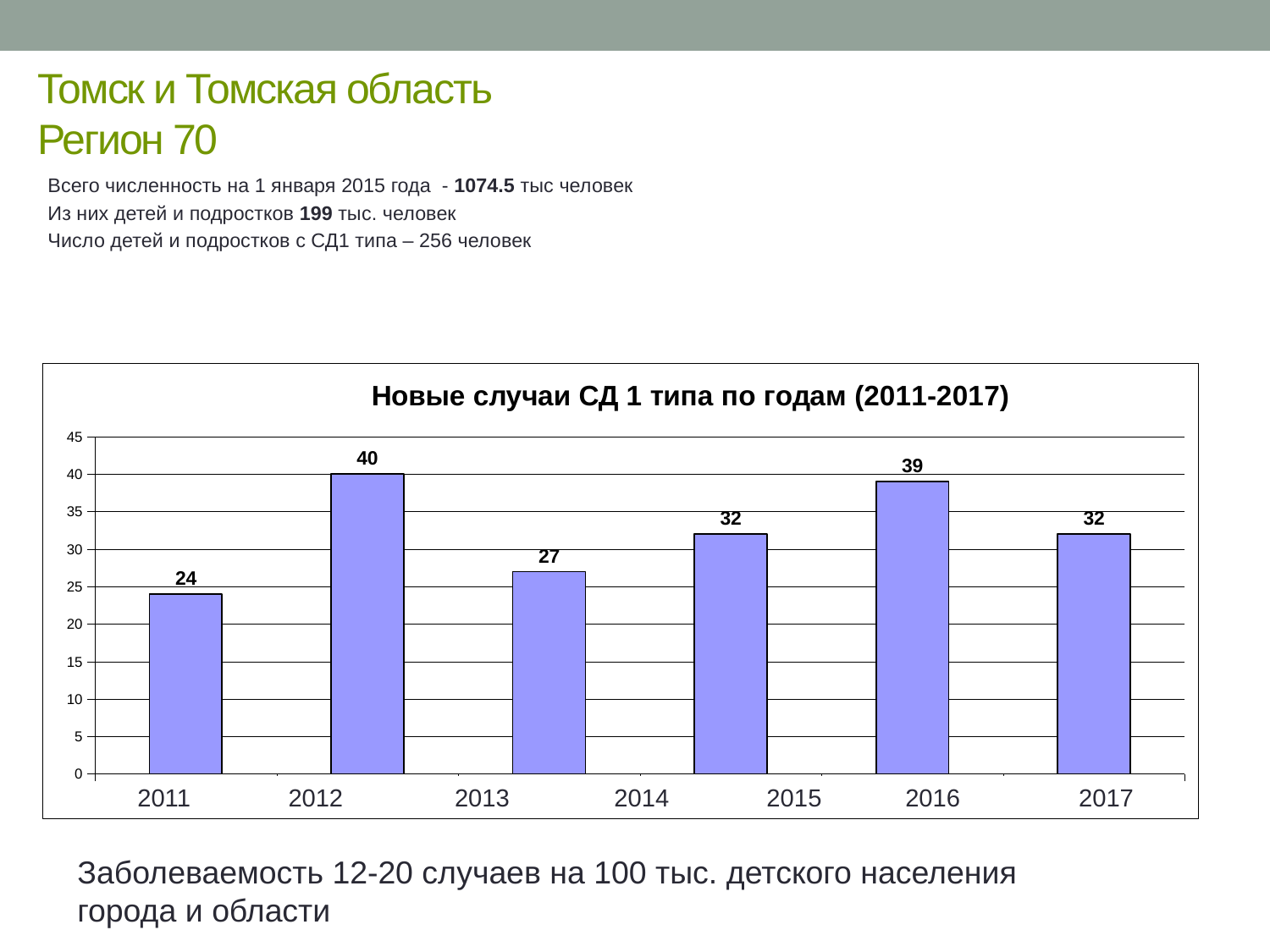
Which is larger: the value of the second bar from the left or the value of the fifth bar from the left? the second bar (40) What is the lowest value shown on any bar in the chart? 24 What is the highest value shown on any bar in the chart? 40 What type of chart is shown on the slide? bar chart What is the maximum value shown on the vertical axis of the chart? 45 What is the value of the leftmost bar in the chart? 24 What is the value of the second bar from the left in the chart? 40 What is the difference between the highest bar value and the lowest bar value in the chart? 16 Is the value of the third bar from the left greater or less than 30? less How many bars are plotted in the chart? 6 What is the value of the rightmost bar in the chart? 32 What is the title of the chart? Новые случаи СД 1 типа по годам (2011-2017)